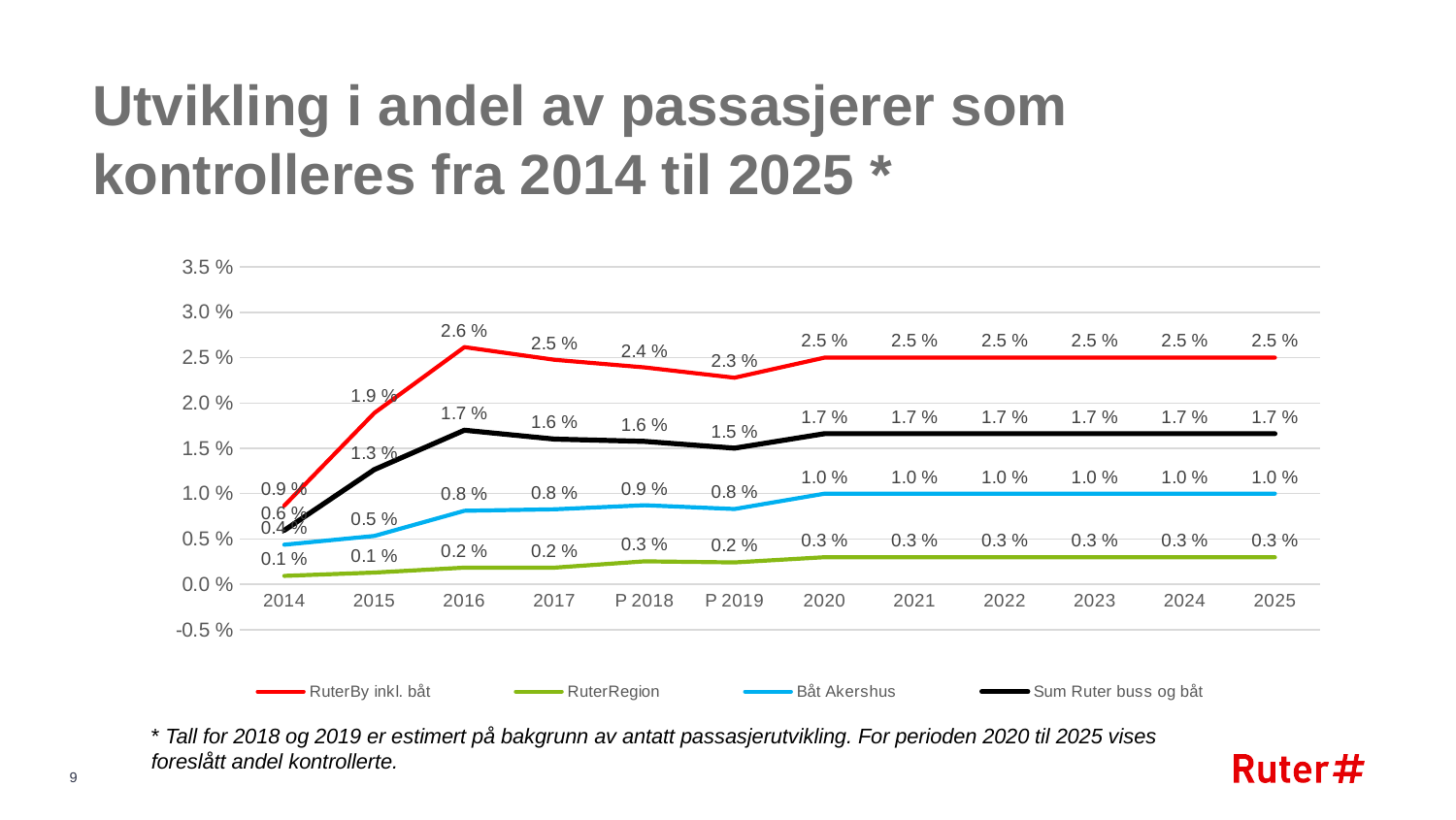
What is the value for RuterRegion in 2025? 0.3 % Does RuterBy inkl. båt rise or fall from 2014 to 2016? rise What is the value for Båt Akershus in P 2018? 0.9 % What is the value for Sum Ruter buss og båt in P 2019? 1.5 % How many years (points) are shown along the x axis? 12 Which is larger in 2015: Båt Akershus or RuterRegion? Båt Akershus How many series does the legend list? 4 What is the value for RuterBy inkl. båt in 2016? 2.6 % Which series has the lowest values across the whole period? RuterRegion What is the difference between RuterBy inkl. båt and Sum Ruter buss og båt in 2020? 0.8 % What type of chart is shown on the slide? line chart In which year does RuterBy inkl. båt reach its highest value? 2016